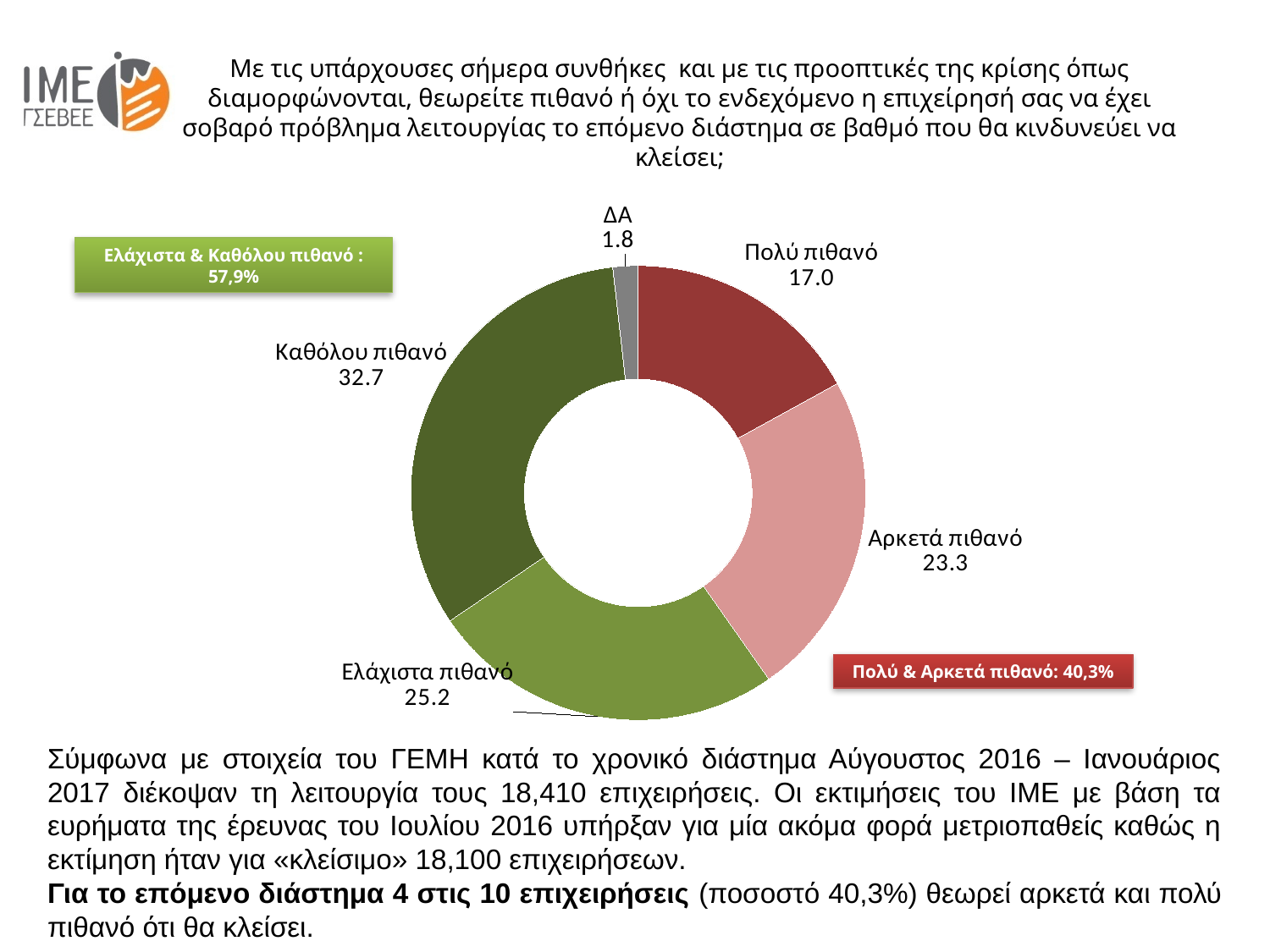
What is the value for "Πολύ πιθανό"? 17.0 What combined percentage does the green callout box give for "Ελάχιστα & Καθόλου πιθανό"? 57,9% What is the value for "ΔΑ"? 1.8 What is the value for "Καθόλου πιθανό"? 32.7 What is the value for "Αρκετά πιθανό"? 23.3 Which category has the smallest slice? ΔΑ What is the difference between the values for "Καθόλου πιθανό" and "Ελάχιστα πιθανό"? 7.5 Which category has the largest slice? Καθόλου πιθανό What combined percentage does the red callout box give for "Πολύ & Αρκετά πιθανό"? 40,3% Which is larger, the value for "Αρκετά πιθανό" or the value for "Πολύ πιθανό"? Αρκετά πιθανό How many categories (slices) does the chart show? 5 What kind of chart is shown on the slide? Doughnut (pie) chart